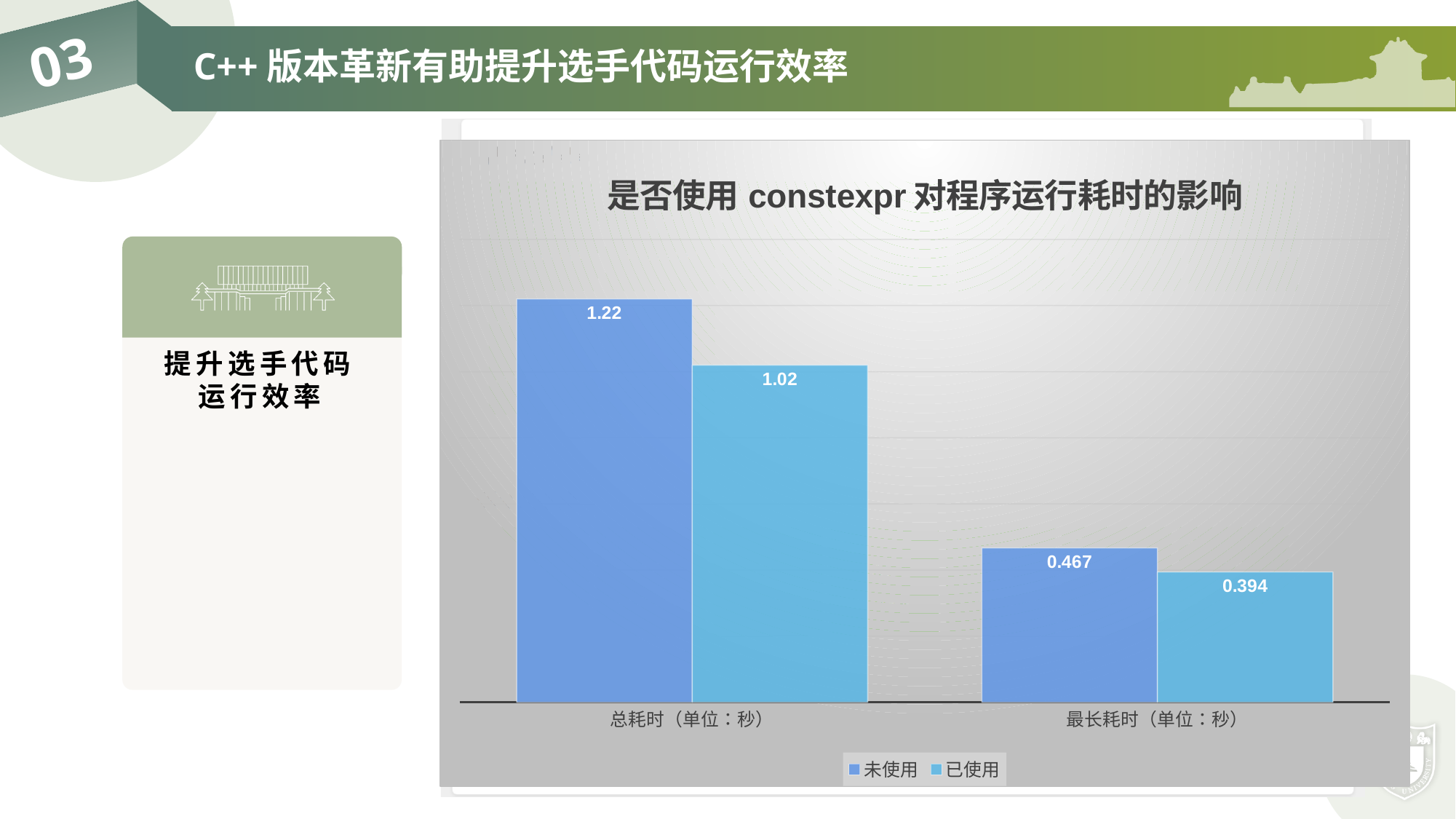
What type of chart is shown on the slide? Bar chart In the 最长耗时（单位：秒） category, which series has the larger value, 未使用 or 已使用? 未使用 What is the value for 已使用 in the 最长耗时（单位：秒） category? 0.394 What is the difference between 未使用 and 已使用 in the 总耗时（单位：秒） category? 0.2 How many categories are shown on the x axis? 2 What is the value for 已使用 in the 总耗时（单位：秒） category? 1.02 What is the value for 未使用 in the 最长耗时（单位：秒） category? 0.467 Which bar has the lowest value in the chart? 已使用 in 最长耗时（单位：秒） What is the value for 未使用 in the 总耗时（单位：秒） category? 1.22 Which bar has the highest value in the chart? 未使用 in 总耗时（单位：秒） How many series does the legend list? 2 What is the difference between 未使用 and 已使用 in the 最长耗时（单位：秒） category? 0.073